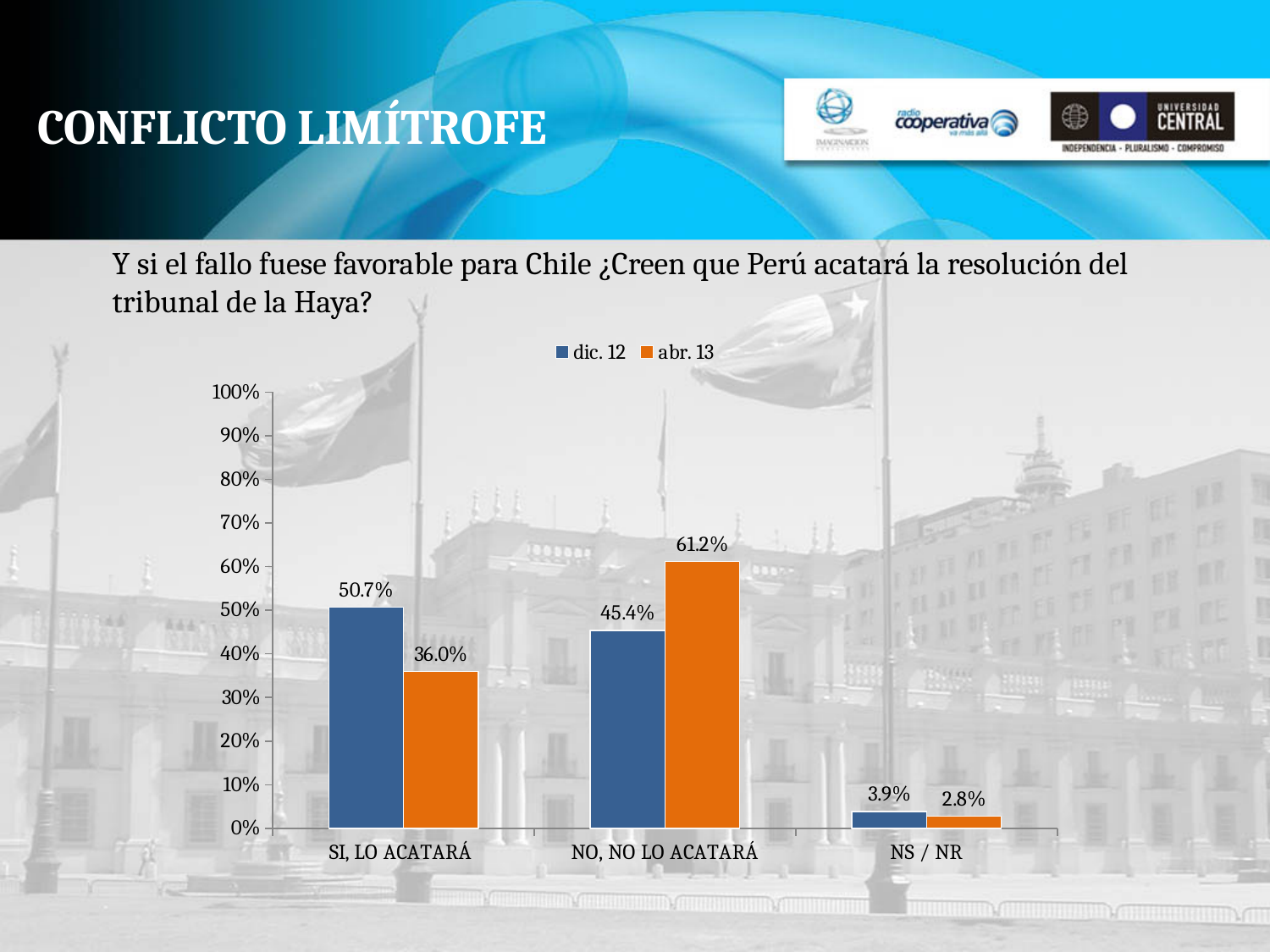
Is the abr. 13 value for "SI, LO ACATARÁ" greater or less than 40%? less Which category has the lowest value in the dic. 12 series? NS / NR Which category has the highest value in the abr. 13 series? NO, NO LO ACATARÁ What is the value for "NO, NO LO ACATARÁ" in the abr. 13 series? 61.2% What is the value for "SI, LO ACATARÁ" in the dic. 12 series? 50.7% How many categories are shown on the x axis? 3 What is the difference between the abr. 13 and dic. 12 values for "NO, NO LO ACATARÁ"? 15.8% For "SI, LO ACATARÁ", which series has the larger value, dic. 12 or abr. 13? dic. 12 How many series does the legend list? 2 Which series is shown in orange? abr. 13 What is the value for "NS / NR" in the dic. 12 series? 3.9% What kind of chart is shown on the slide? bar chart